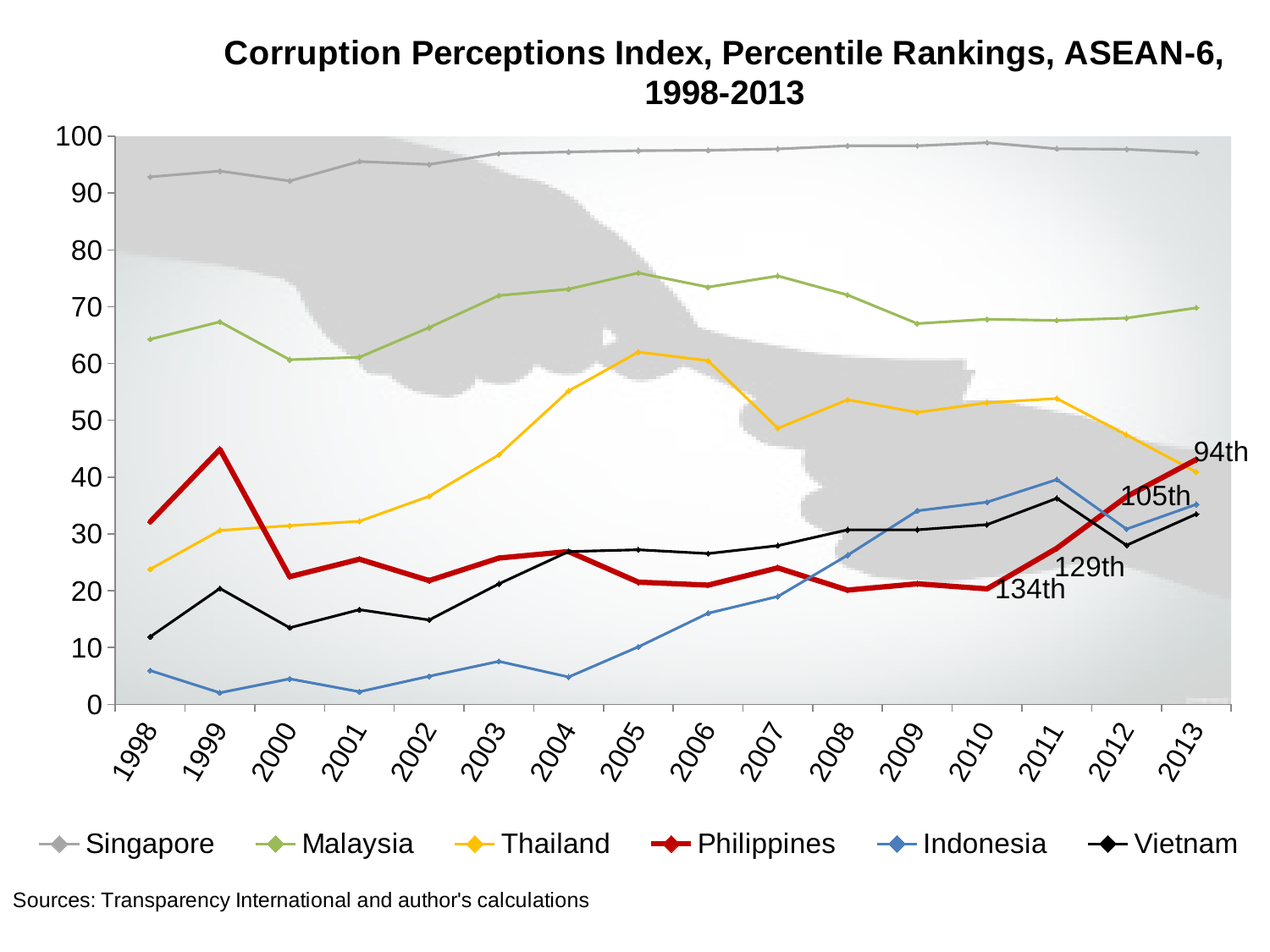
How many countries does the legend list? 6 What rank label is printed next to the Philippines line for 2013? 94th In 2005, which has the higher percentile ranking, Malaysia or Thailand? Malaysia Does Indonesia's percentile ranking generally rise or fall from 1998 to 2013? rise Is the value for Indonesia in 1998 greater or less than 10? less Is the value for Singapore in 2013 greater or less than 90? greater How many years are shown on the x axis? 16 Which country has the highest percentile ranking in 2013? Singapore Which country has the lowest percentile ranking in 1998? Indonesia What kind of chart is shown on the slide? line chart Is the value for the Philippines in 1999 greater or less than 40? greater What is the title of the chart? Corruption Perceptions Index, Percentile Rankings, ASEAN-6, 1998-2013